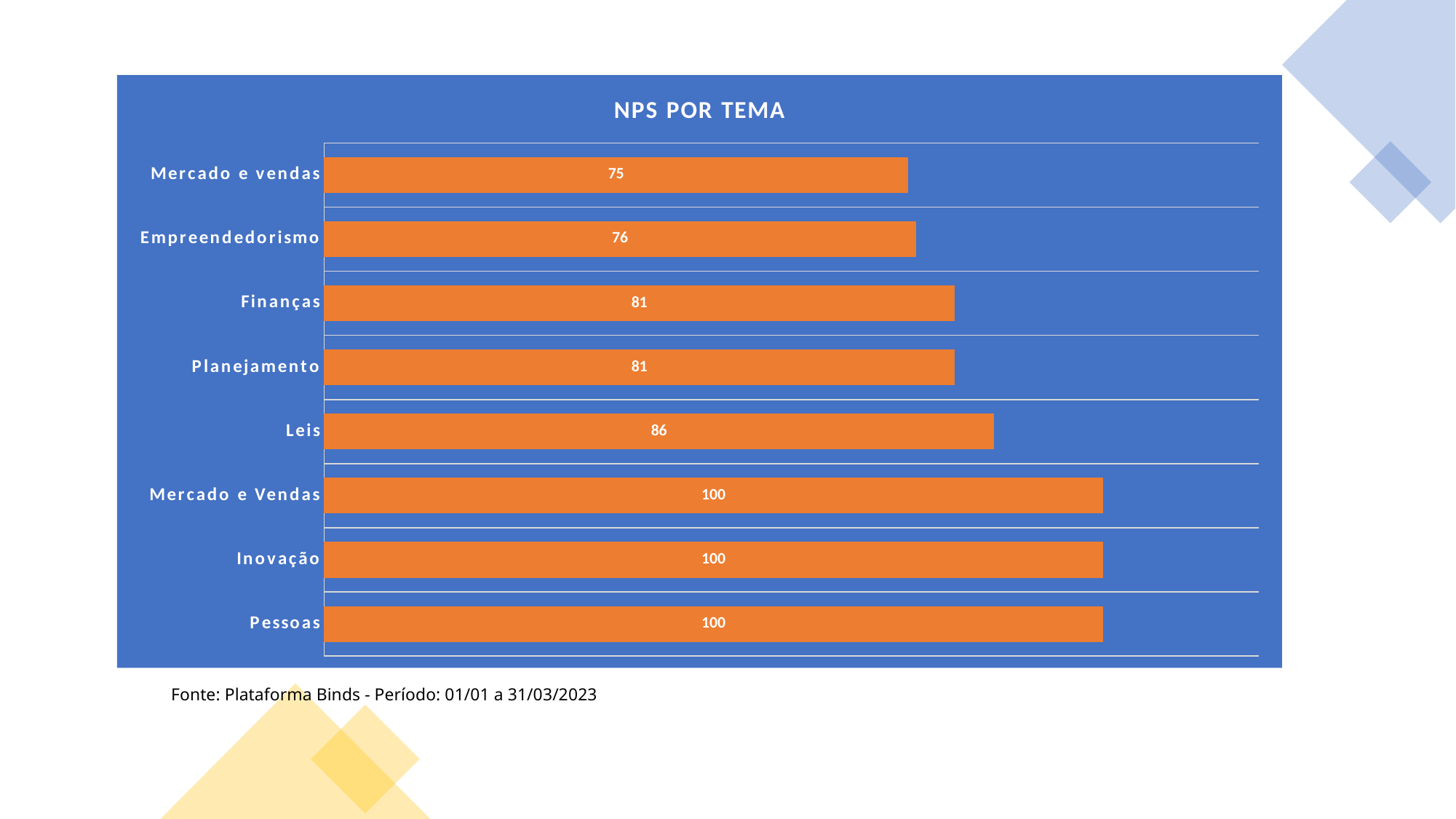
How many categories are shown in the chart? 8 What type of chart is shown on the slide? Bar chart What is the value for Empreendedorismo? 76 What is the value for Leis? 86 Which category has the lowest value in the chart? Mercado e vendas (the top bar) What is the value for Pessoas? 100 Which is larger, the value for Leis or the value for Planejamento? Leis What is the title of the chart? NPS POR TEMA What is the value for Inovação? 100 What is the value for Finanças? 81 What is the difference between the values for Leis and Empreendedorismo? 10 What is the value of the top bar, labelled 'Mercado e vendas'? 75